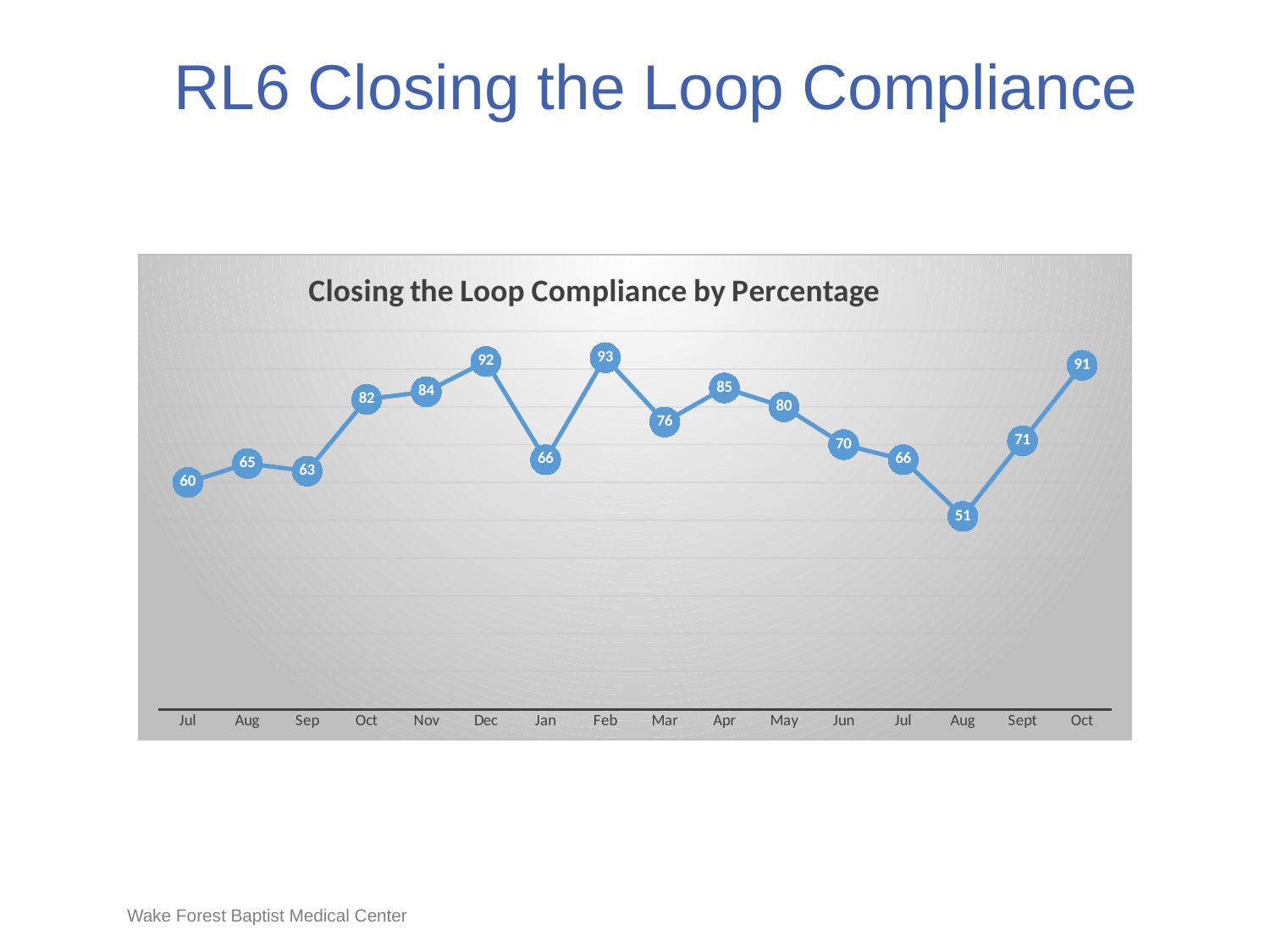
What type of chart is shown on the slide? line chart What is the title of the chart? Closing the Loop Compliance by Percentage What is the value for Dec? 92 Which is larger, the value for Nov or the value for Mar? Nov How many data points are plotted on the chart? 16 Which month has the lowest value? the second Aug What is the value for the second Aug on the x axis? 51 Which month has the highest value? Feb What is the value for Sept? 71 What is the difference between the values for Feb and Jan? 27 Do the values rise or fall from the second Aug to the final Oct? rise What is the value for Feb? 93